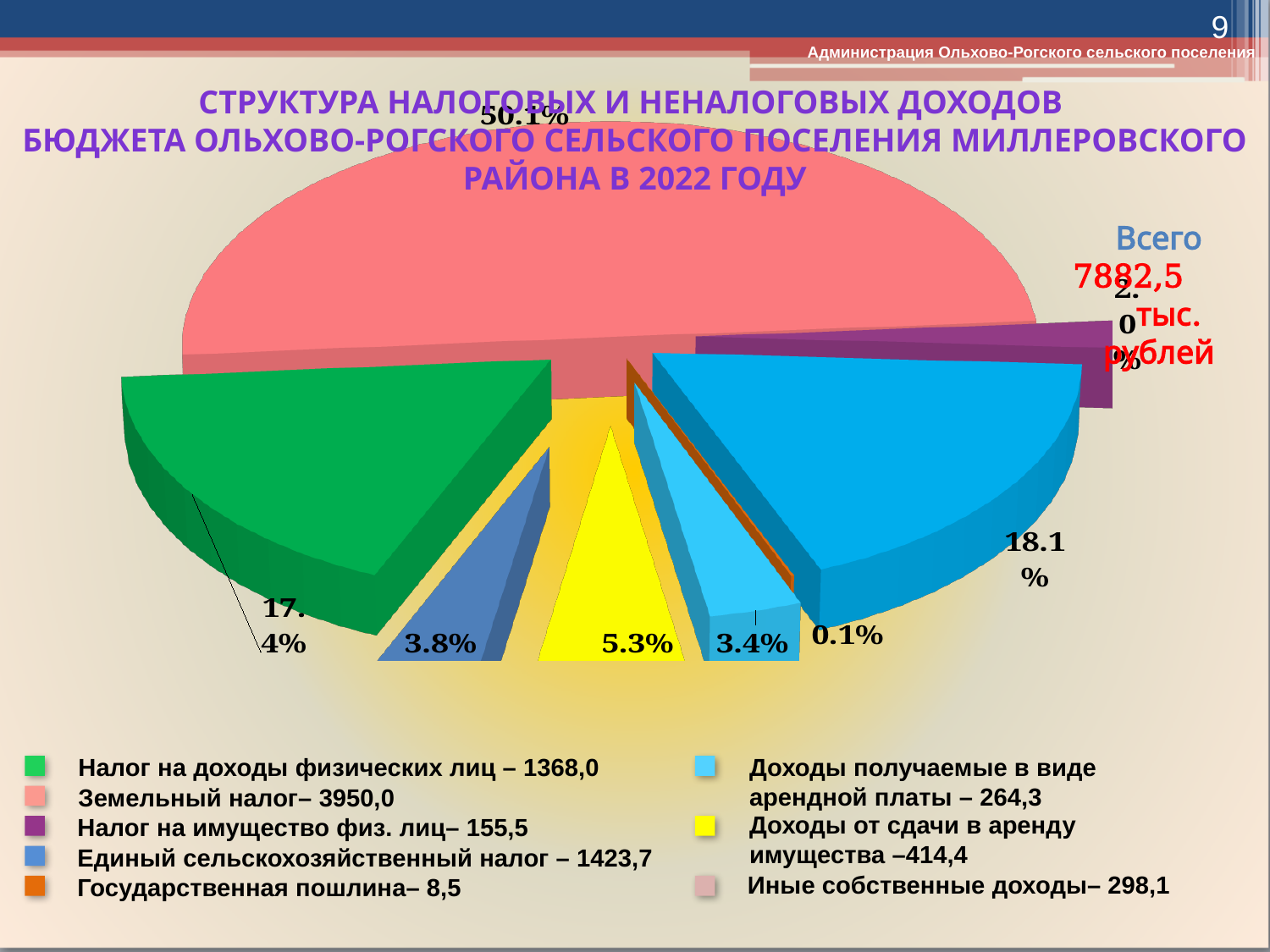
Which category has the smallest slice of the pie? Государственная пошлина What is the total amount (Всего) shown next to the pie chart? 7882,5 тыс. рублей What share of the pie does Единый сельскохозяйственный налог take? 18.1% Which is larger, the slice for Земельный налог or the slice for Налог на доходы физических лиц? Земельный налог What share of the pie does Земельный налог take? 50.1% What share of the pie does Налог на доходы физических лиц take? 17.4% Which category has the largest slice of the pie? Земельный налог What kind of chart is shown on the slide? Pie chart What value does the legend give for Государственная пошлина? 8,5 How many categories are listed in the legend? 8 What value does the legend give for Единый сельскохозяйственный налог? 1423,7